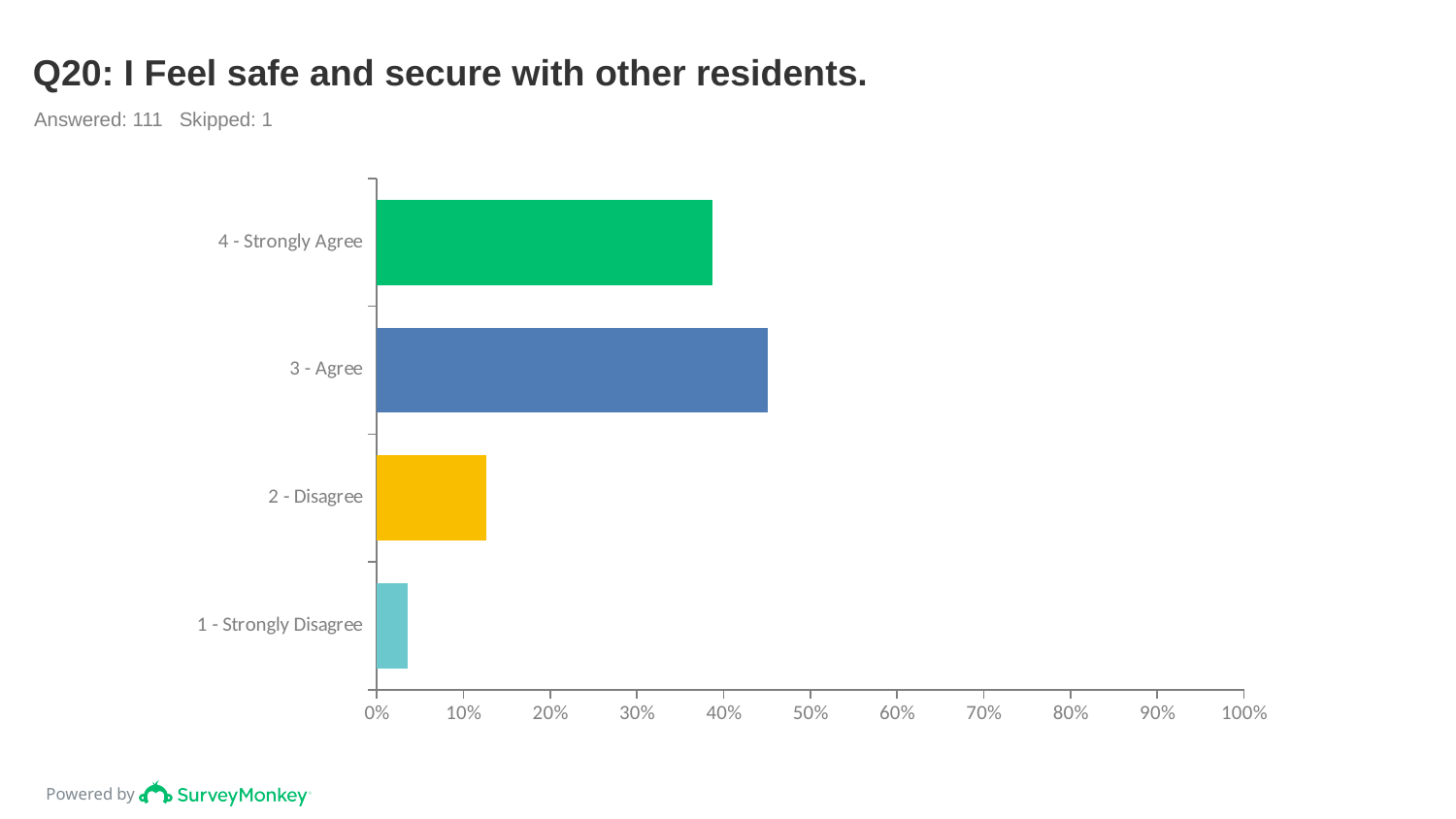
How many respondents answered the question according to the slide? 111 Is the value for 3 - Agree greater or less than 40%? greater How many response categories are plotted in the chart? 4 What kind of chart is shown on the slide? bar chart Is the value for 1 - Strongly Disagree greater or less than 10%? less Is the value for 2 - Disagree greater or less than 10%? greater Which is larger, the value for 4 - Strongly Agree or the value for 2 - Disagree? 4 - Strongly Agree Which is larger, the value for 2 - Disagree or the value for 1 - Strongly Disagree? 2 - Disagree What is the title of the chart? Q20: I Feel safe and secure with other residents. Which response category has the highest value? 3 - Agree Which response category has the lowest value? 1 - Strongly Disagree